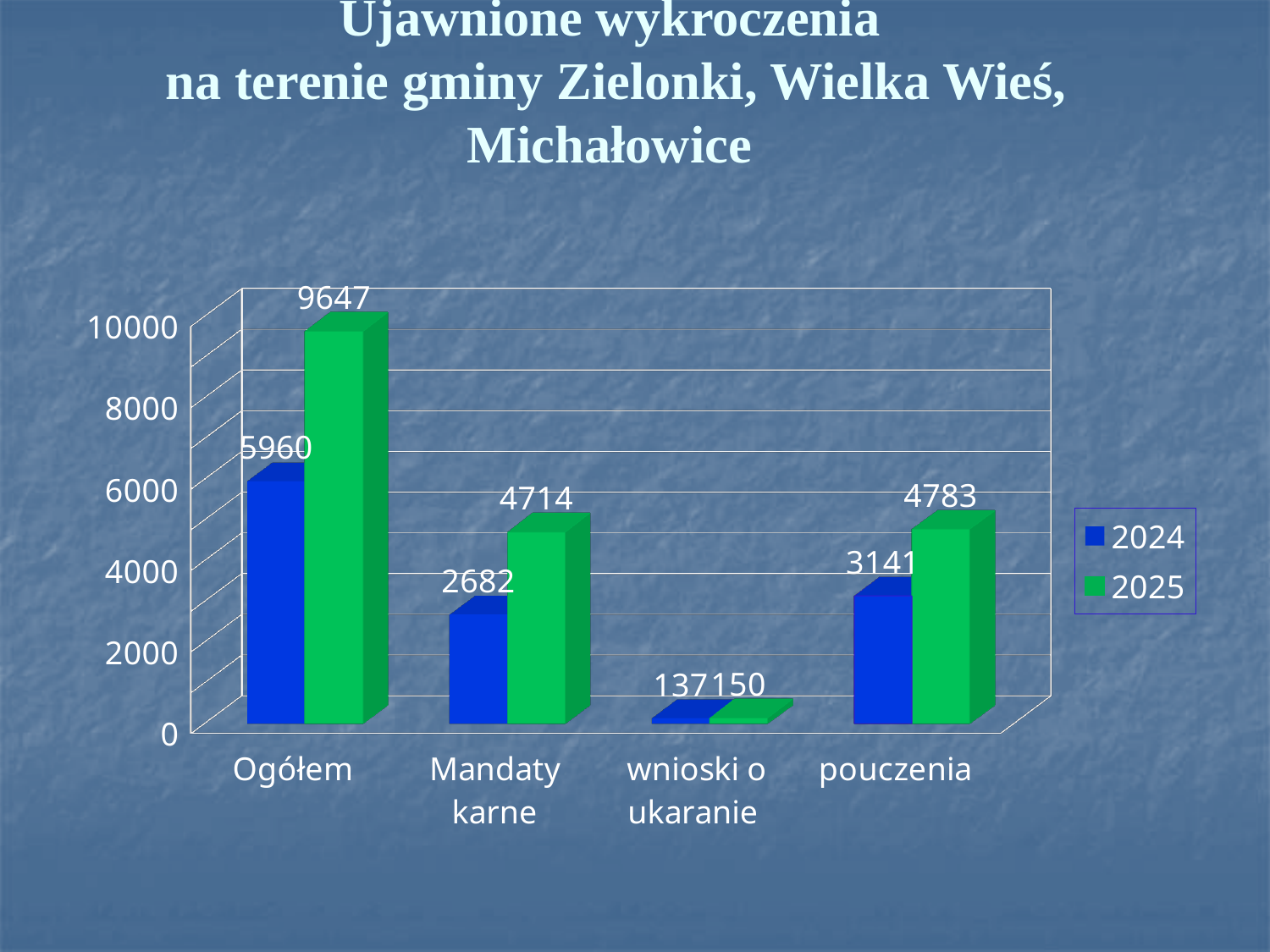
How many series does the legend list? 2 Which is larger for pouczenia: the 2024 value or the 2025 value? 2025 What kind of chart is shown on the slide? bar chart Which category has the highest value in the 2024 series? Ogółem What is the value for pouczenia in the 2025 series? 4783 What is the value for Ogółem in the 2025 series? 9647 What is the difference between the 2025 and 2024 values for Ogółem? 3687 Which category has the lowest value in the 2025 series? wnioski o ukaranie What is the value for wnioski o ukaranie in the 2024 series? 137 How many categories are shown on the x axis? 4 What is the value for Mandaty karne in the 2024 series? 2682 What is the difference between the 2025 and 2024 values for Mandaty karne? 2032